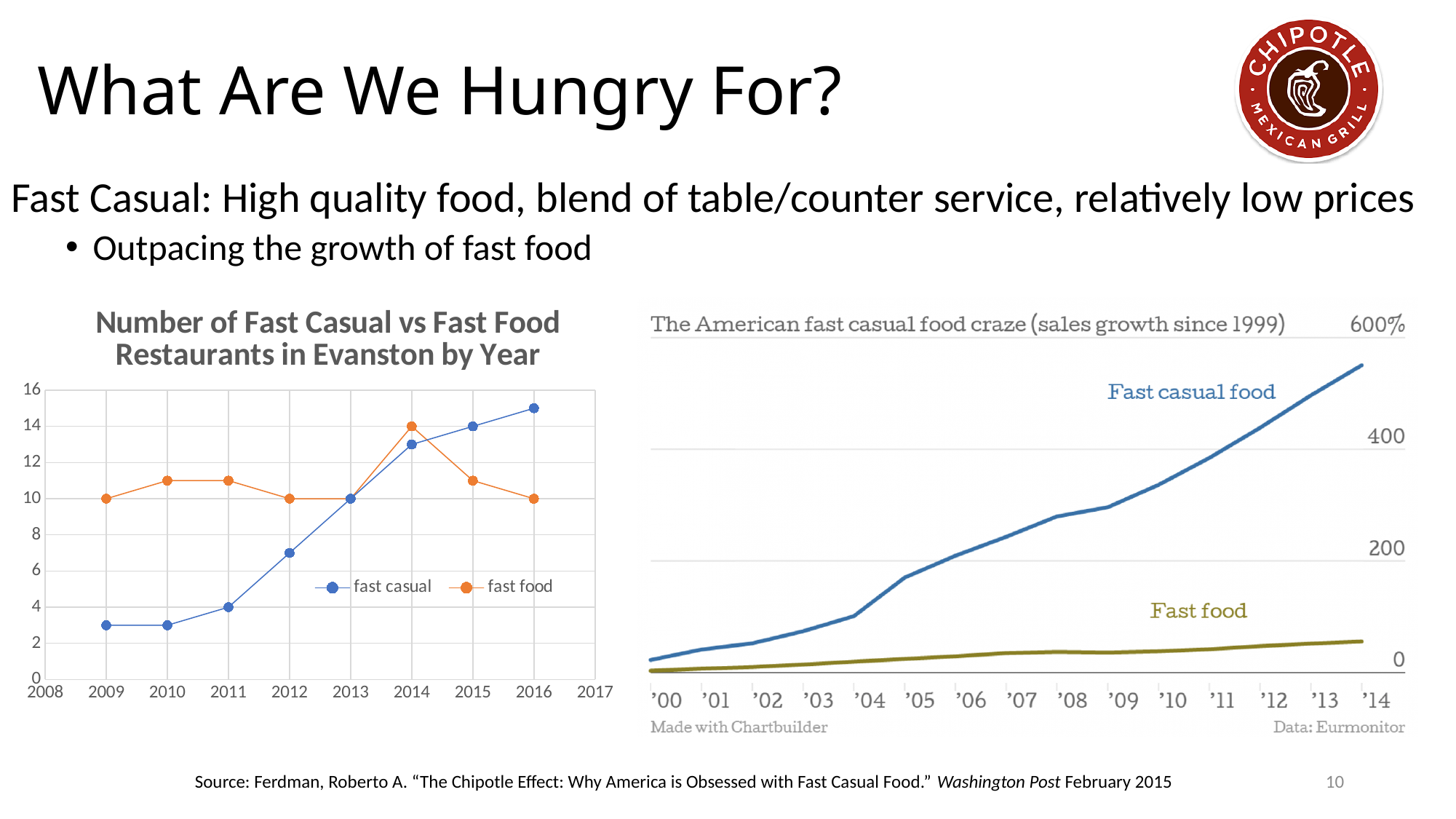
In the left chart, Number of Fast Casual vs Fast Food Restaurants in Evanston by Year, is the value for fast casual in 2009 greater or less than 4? less In the left chart, Number of Fast Casual vs Fast Food Restaurants in Evanston by Year, what is the value for fast food in 2014? 14 In the right chart, The American fast casual food craze, is the value for Fast casual food in '14 greater or less than 400? greater In the left chart, Number of Fast Casual vs Fast Food Restaurants in Evanston by Year, which series has the larger value in 2016, fast casual or fast food? fast casual In the left chart, Number of Fast Casual vs Fast Food Restaurants in Evanston by Year, what is the value for fast casual in 2015? 14 In the left chart, Number of Fast Casual vs Fast Food Restaurants in Evanston by Year, in which year does the fast food series reach its highest value? 2014 In the right chart, The American fast casual food craze, is the value for Fast food in '14 greater or less than 200? less In the left chart, Number of Fast Casual vs Fast Food Restaurants in Evanston by Year, what kind of chart is shown? line chart In the left chart, Number of Fast Casual vs Fast Food Restaurants in Evanston by Year, does the fast casual series rise or fall from 2009 to 2016? rise In the left chart, Number of Fast Casual vs Fast Food Restaurants in Evanston by Year, what is the value for fast casual in 2013? 10 In the right chart, The American fast casual food craze, which series is higher in '14, Fast casual food or Fast food? Fast casual food In the left chart, Number of Fast Casual vs Fast Food Restaurants in Evanston by Year, how many series does the legend list? 2